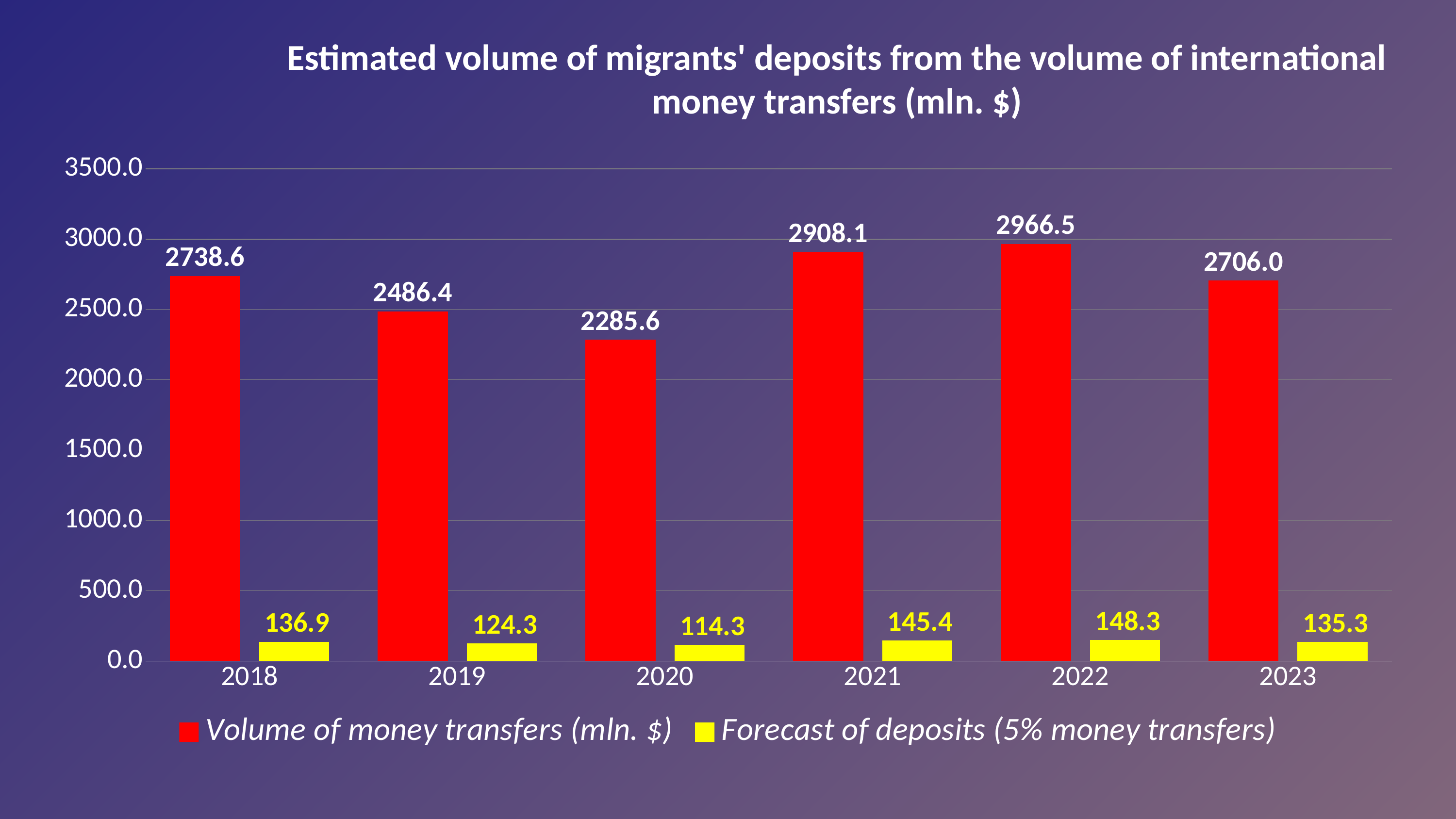
Does the volume of money transfers rise or fall from 2018 to 2020? fall What kind of chart is shown on the slide? bar chart Which is larger, the volume of money transfers in 2018 or in 2023? 2018 What is the forecast of deposits (5% money transfers) for 2022? 148.3 Which year has the highest volume of money transfers? 2022 How many series does the legend list? 2 What colour are the bars for the forecast of deposits series? yellow What is the volume of money transfers (mln. $) in 2020? 2285.6 Which year has the lowest forecast of deposits? 2020 What is the difference between the volume of money transfers in 2022 and in 2020? 680.9 How many years are shown on the x axis? 6 Is the volume of money transfers in 2019 greater or less than 2500.0? less